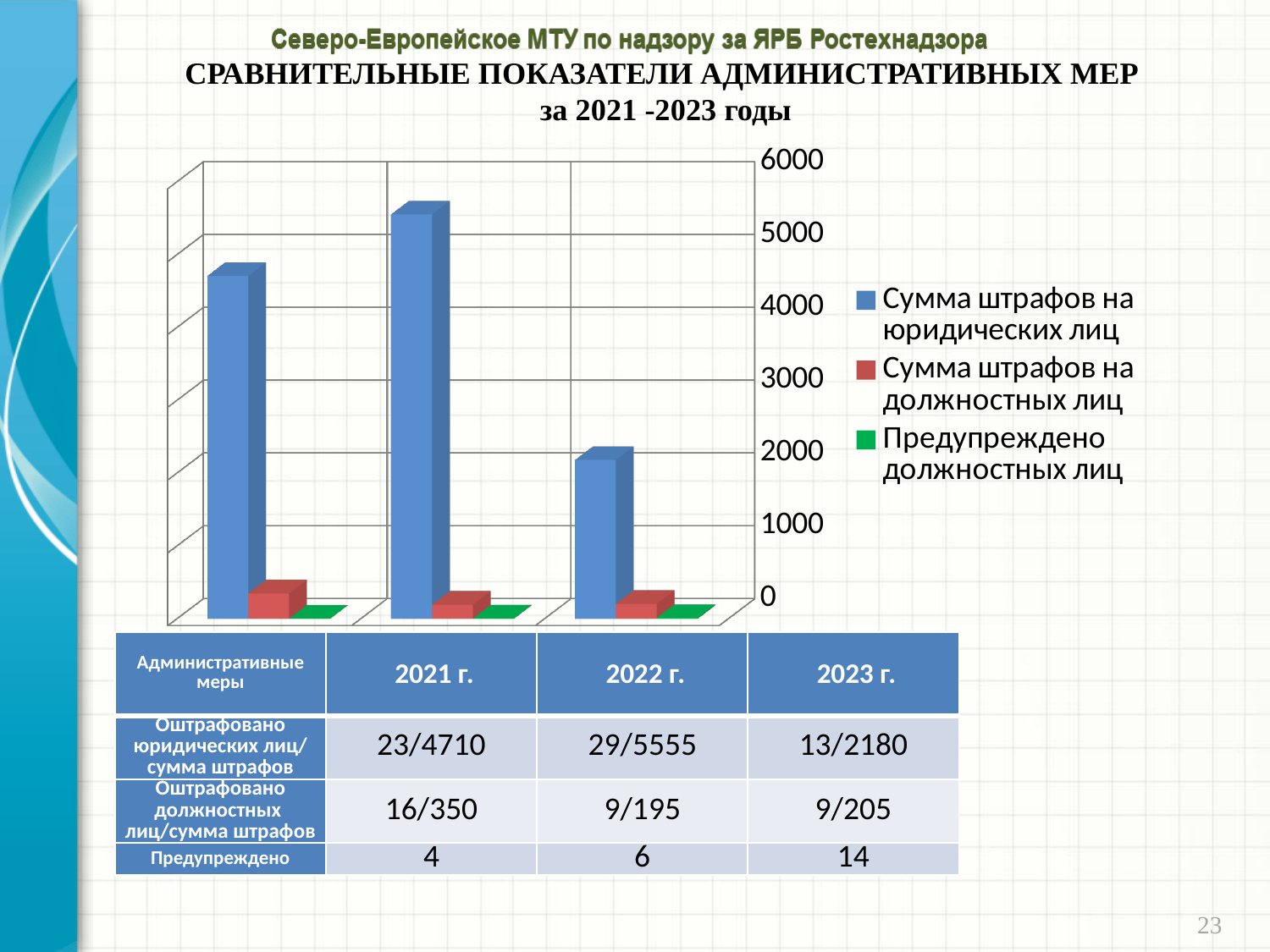
Is the 2021 bar for 'Сумма штрафов на юридических лиц' greater or less than 4000? greater Which year has the shortest bar for 'Сумма штрафов на юридических лиц'? 2023 Is the 2022 bar for 'Сумма штрафов на юридических лиц' greater or less than 5000? greater What colour represents 'Предупреждено должностных лиц' in the chart legend? green How many series does the chart legend list? 3 Which is larger: the 'Сумма штрафов на юридических лиц' bar for 2021 or for 2023? 2021 According to the table under the chart, what is the sum of fines on legal entities (сумма штрафов, юридических лиц) in 2022? 5555 What kind of chart is shown on the slide? bar chart How many groups of bars (years) are plotted in the chart? 3 Which year has the tallest bar for 'Сумма штрафов на юридических лиц'? 2022 Is the 2023 bar for 'Сумма штрафов на юридических лиц' greater or less than 3000? less Using the table values, what is the difference between the sum of fines on legal entities in 2022 (5555) and in 2021 (4710)? 845